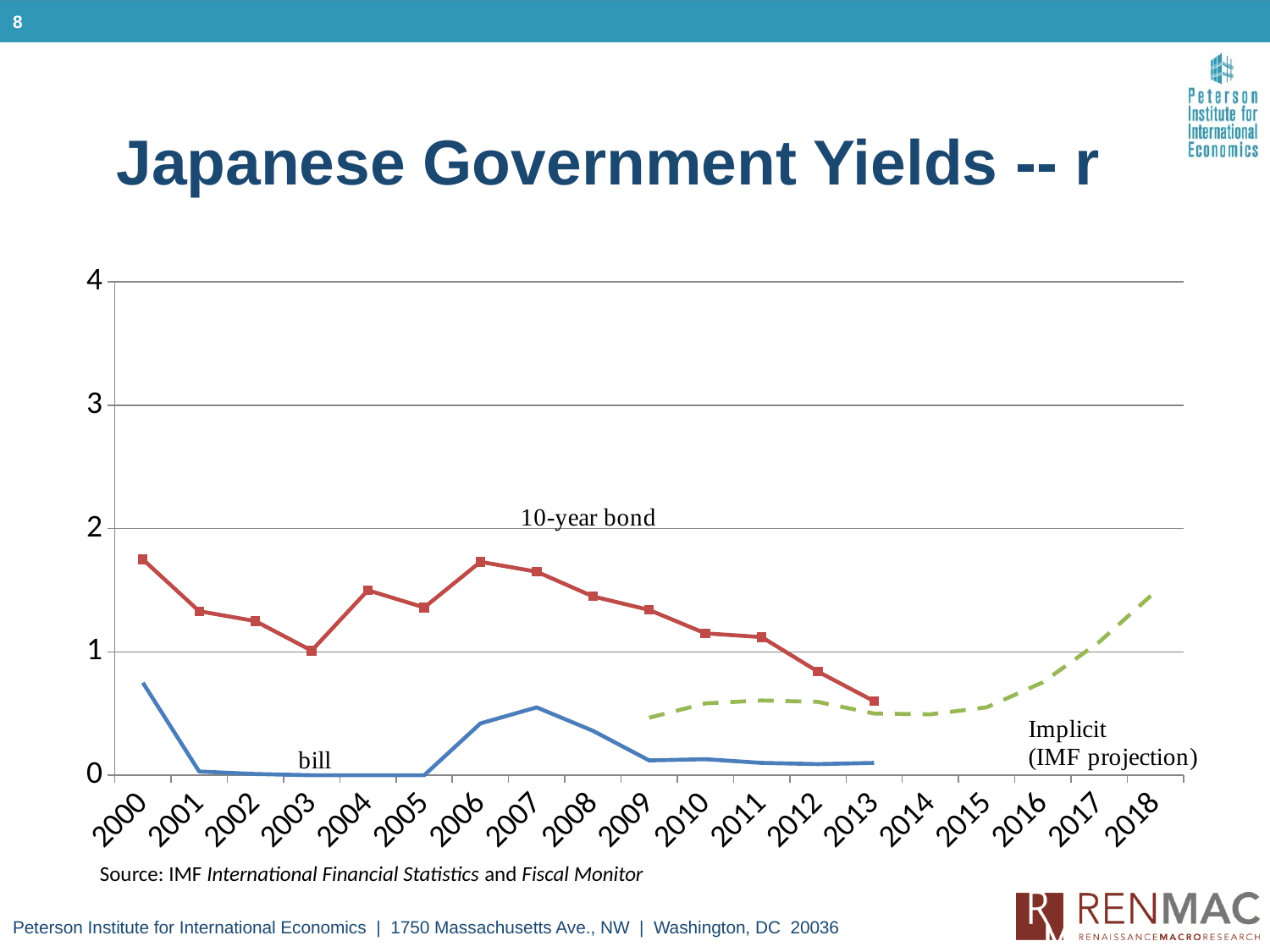
In which year is the 10-year bond yield at its lowest? 2013 In which year does the Implicit (IMF projection) series reach its highest value? 2018 What kind of chart is shown on the slide? line chart How many series are plotted on the chart? 3 Is the 10-year bond yield in 2000 greater or less than 1? greater How many years are labelled on the x axis of the chart? 19 In 2006, which is higher: the 10-year bond yield or the bill yield? 10-year bond Is the Implicit (IMF projection) value in 2018 greater or less than 1? greater Is the bill yield in 2000 greater or less than 1? less Does the 10-year bond yield rise or fall from 2006 to 2013? fall Which is higher for the 10-year bond: the 2003 value or the 2004 value? 2004